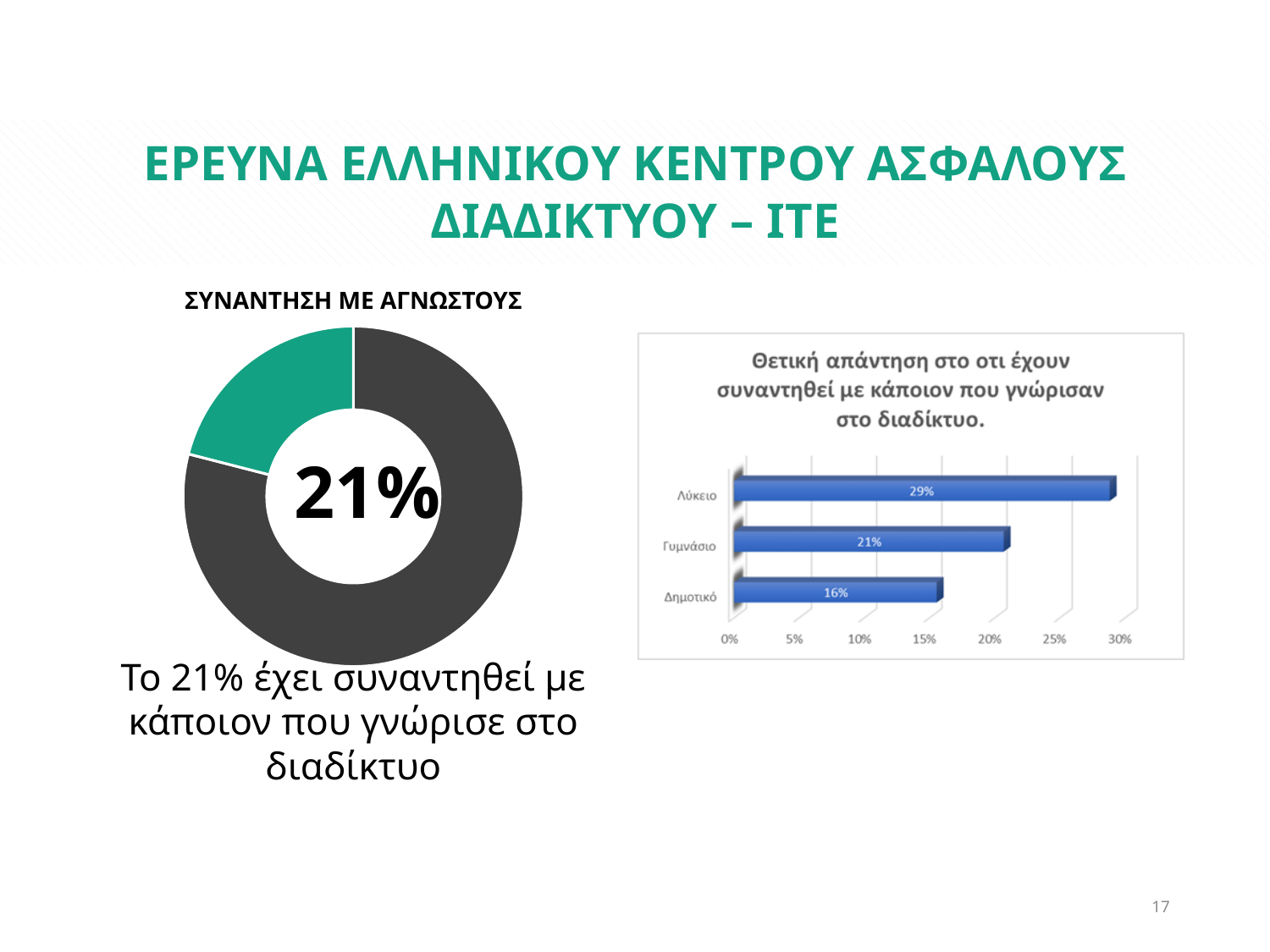
In the bar chart on the right, what is the difference between the values for Γυμνάσιο and Δημοτικό? 5% What kind of chart is the chart on the left of the slide, titled ΣΥΝΑΝΤΗΣΗ ΜΕ ΑΓΝΩΣΤΟΥΣ? Donut chart In the bar chart on the right, which category has the lowest value? Δημοτικό In the bar chart on the right, which category has the highest value? Λύκειο What kind of chart is the chart on the right of the slide? Bar chart In the bar chart on the right, what is the value for Δημοτικό? 16% In the donut chart titled ΣΥΝΑΝΤΗΣΗ ΜΕ ΑΓΝΩΣΤΟΥΣ, what percentage is shown in the centre? 21% In the bar chart on the right, what is the value for Λύκειο? 29% In the bar chart on the right, what is the value for Γυμνάσιο? 21% In the bar chart on the right, what is the difference between the values for Λύκειο and Δημοτικό? 13% In the bar chart on the right, which is larger, the value for Λύκειο or the value for Γυμνάσιο? Λύκειο In the bar chart on the right, how many categories are shown? 3